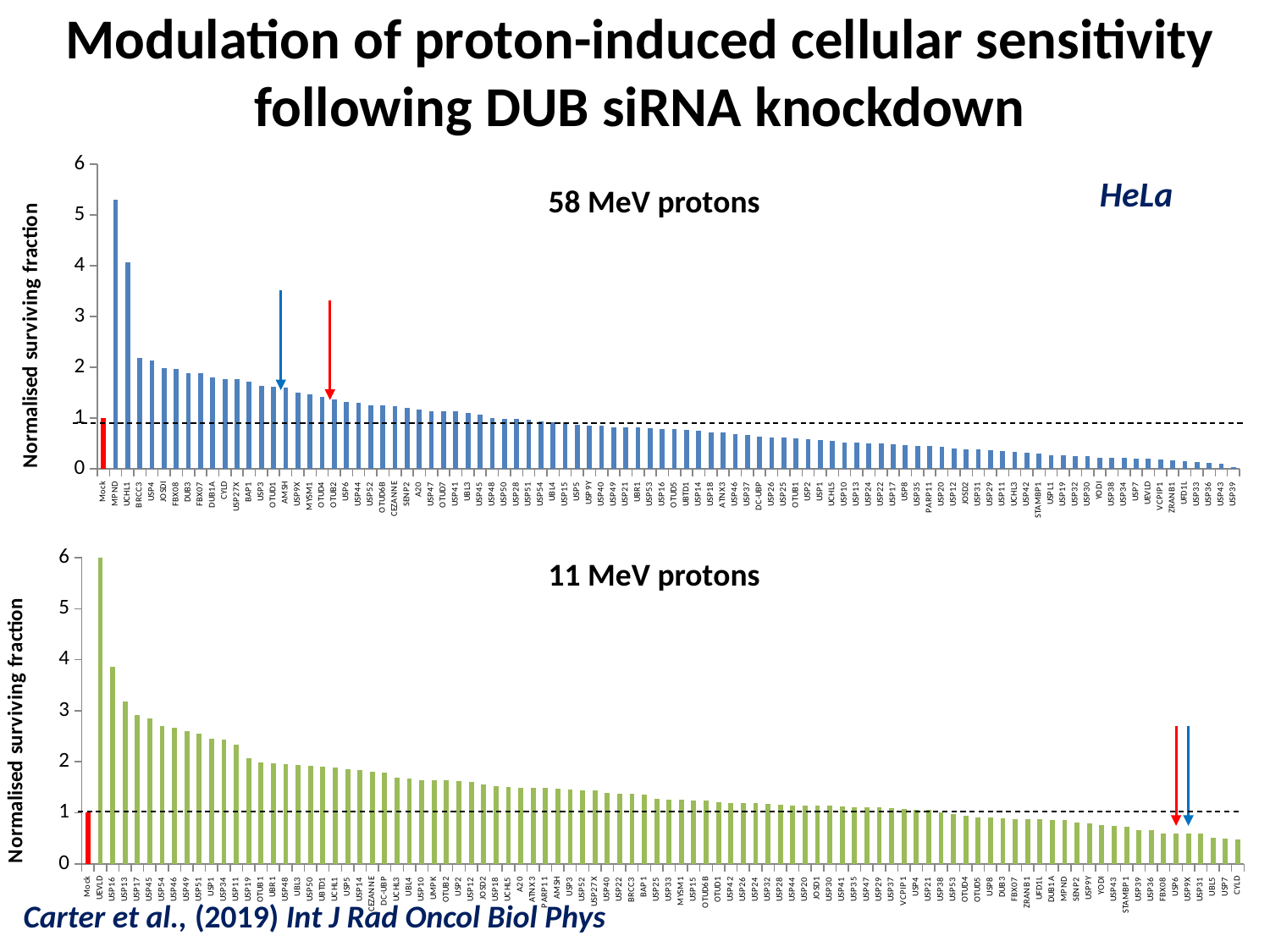
In the '11 MeV protons' chart, is the value for UEVLD greater or less than 5? greater In the '58 MeV protons' chart, which DUB knockdown has the lowest normalised surviving fraction? USP39 What colour are the bars in the '11 MeV protons' chart (excluding the Mock bar)? green In the '58 MeV protons' chart, is the value for UCHL1 greater or less than 3? greater What is the y-axis title of the '11 MeV protons' chart? Normalised surviving fraction In the '58 MeV protons' chart, which is larger, the value for MPND or the value for UCHL1? MPND In the '58 MeV protons' chart, is the value for MPND greater or less than 5? greater In the '11 MeV protons' chart, do the bar values rise or fall from left to right along the x axis? fall In the '11 MeV protons' chart, which DUB knockdown has the highest normalised surviving fraction? UEVLD What kind of chart is the '58 MeV protons' chart? bar chart In the '58 MeV protons' chart, which DUB knockdown has the highest normalised surviving fraction? MPND